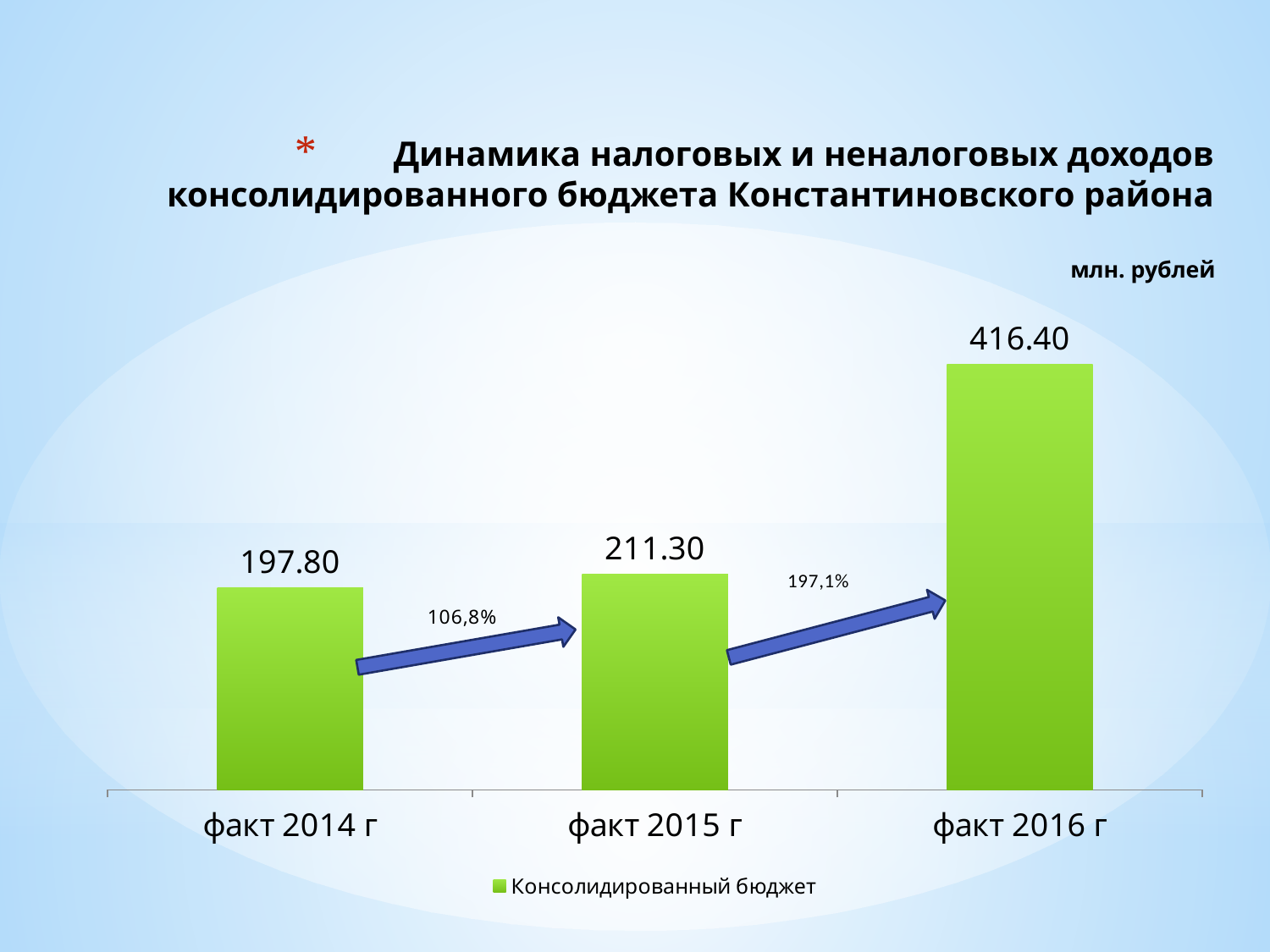
What is the value for факт 2014 г? 197.80 What is the value for факт 2016 г? 416.40 How many categories are shown on the x axis? 3 Which category has the lowest value? факт 2014 г What is the difference between the values for факт 2016 г and факт 2015 г? 205.10 How many series does the legend list? 1 Which is larger, the value for факт 2014 г or факт 2016 г? факт 2016 г What kind of chart is shown on the slide? bar chart Which category has the highest value? факт 2016 г Do the values rise or fall from факт 2014 г to факт 2016 г? rise What is the value for факт 2015 г? 211.30 What is the difference between the values for факт 2015 г and факт 2014 г? 13.50